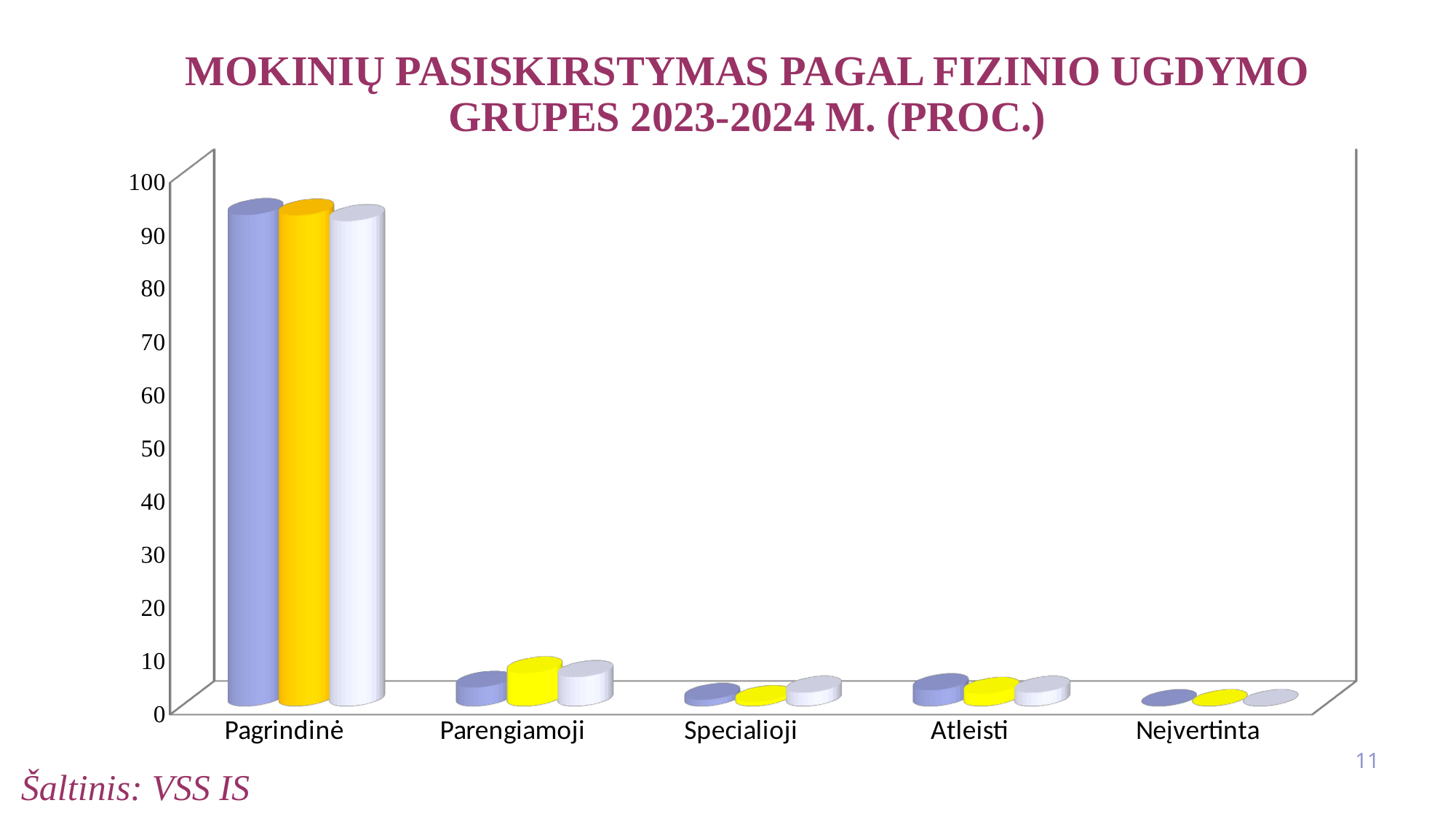
Are the values for Pagrindinė greater or less than 80? greater Which category has larger values, Parengiamoji or Neįvertinta? Parengiamoji How many categories are shown on the x axis of the chart? 5 Which category has the lowest values in the chart? Neįvertinta What source is cited below the chart? VSS IS Are the values for Parengiamoji greater or less than 20? less Which category has larger values, Pagrindinė or Parengiamoji? Pagrindinė What is the title of the chart? MOKINIŲ PASISKIRSTYMAS PAGAL FIZINIO UGDYMO GRUPES 2023-2024 M. (PROC.) Which category has the highest values in the chart? Pagrindinė Are the values for Neįvertinta greater or less than 10? less What kind of chart is shown on the slide? bar chart